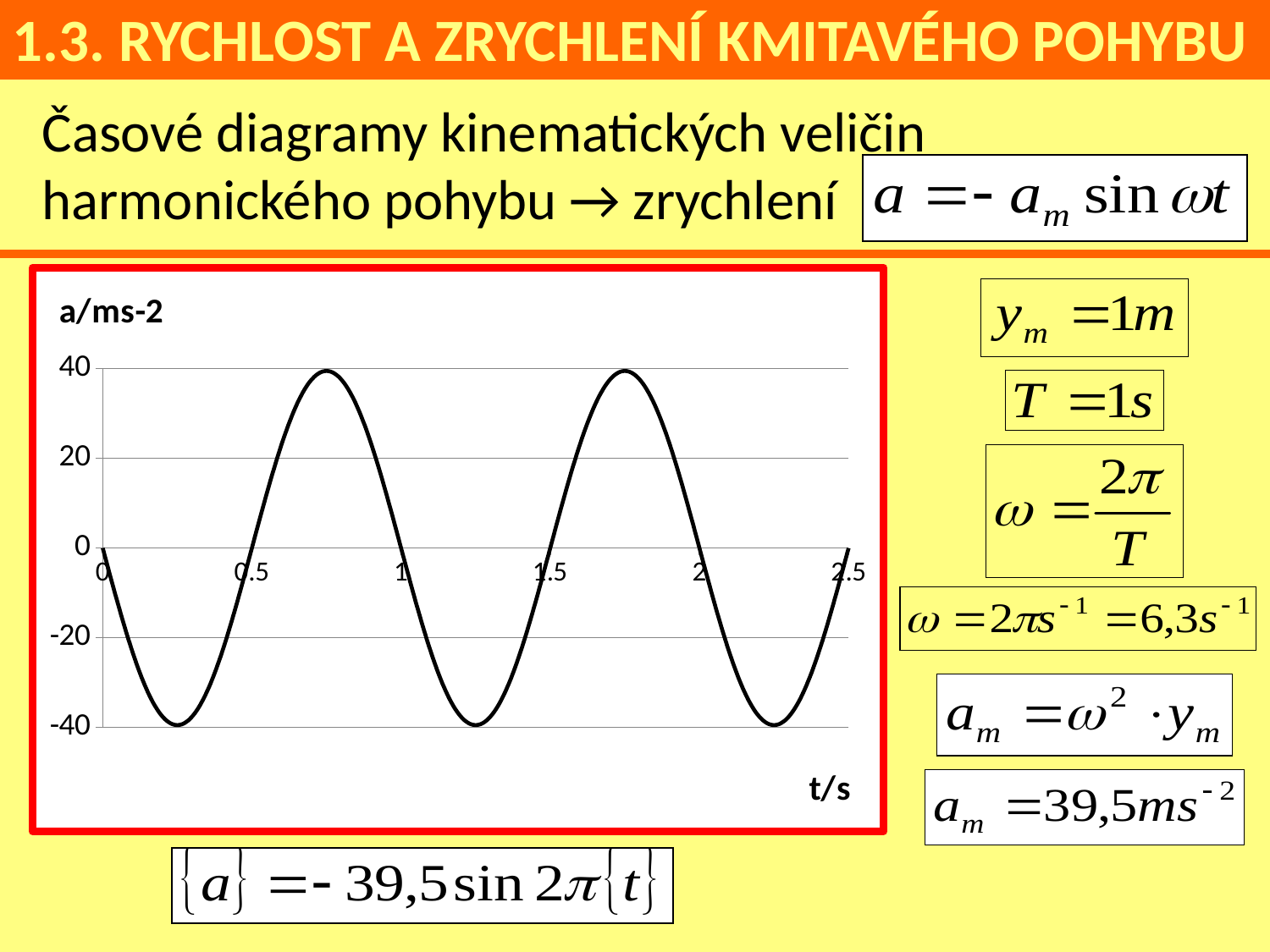
What is the highest tick value shown on the vertical axis? 40 What is the value of a at t = 1 on the chart? 0 Does the value of a rise or fall as t goes from 0.25 to 0.75? rise Which is larger, the value of a at t = 0.75 or at t = 1.25? t = 0.75 Is the value of a at t = 1.75 greater or less than 20? greater What kind of chart is shown on the slide? line chart What is the label of the horizontal axis of the chart? t/s Does the value of a rise or fall as t goes from 0 to 0.25? fall What is the value of a at t = 0 on the chart? 0 What is the label of the vertical axis of the chart? a/ms-2 Is the value of a at t = 0.75 greater or less than 20? greater Is the value of a at t = 0.25 greater or less than -20? less